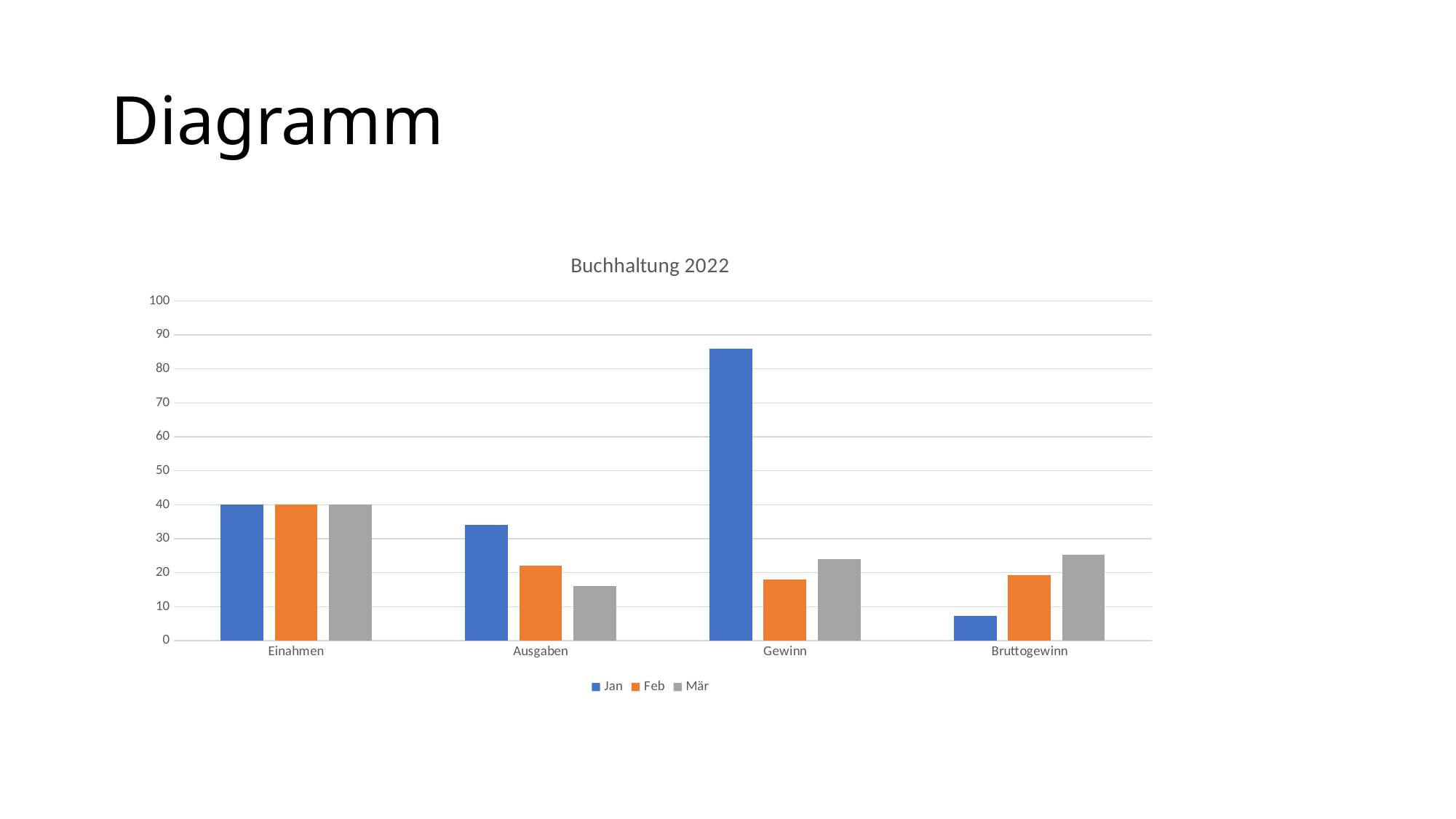
What kind of chart is shown on the slide? bar chart How many series does the legend list? 3 Which series is shown in orange in the legend? Feb Which series has the lowest bar in the Bruttogewinn category? Jan Is the value for Jan in the Bruttogewinn category greater or less than 10? less How many categories are shown on the x axis? 4 Is the value for Mär in the Ausgaben category greater or less than 20? less What is the title of the chart? Buchhaltung 2022 Which is larger in the Gewinn category, the Jan value or the Mär value? Jan Which category has the highest bar in the chart? Gewinn Is the value for Jan in the Gewinn category greater or less than 80? greater What is the value for Jan in the Einahmen category? 40